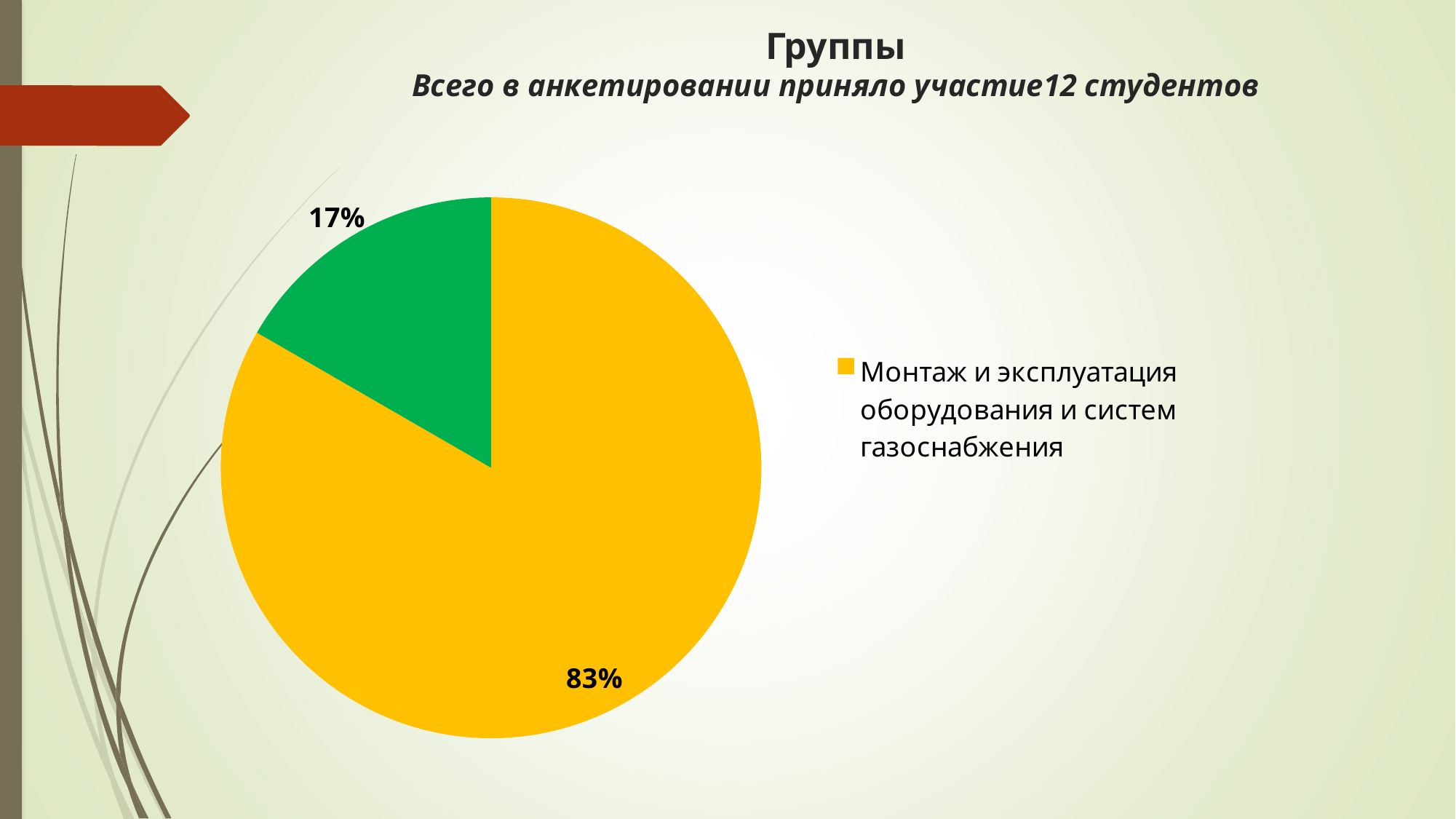
How many slices does the pie chart have? 2 What share of the pie does the slice for "Монтаж и эксплуатация оборудования и систем газоснабжения" take? 83% What share of the pie does the green slice take? 17% Which slice of the pie is the largest? the yellow slice (Монтаж и эксплуатация оборудования и систем газоснабжения), 83% How many entries does the legend list? 1 What is the difference in percentage points between the yellow slice and the green slice? 66 percentage points What is the title of the chart on the slide? Группы Which slice of the pie is the smallest? the green slice, 17% What kind of chart is shown on the slide? pie chart What is the value printed on the yellow slice of the pie? 83% Which is larger, the yellow slice or the green slice? the yellow slice What is the value printed on the green slice of the pie? 17%